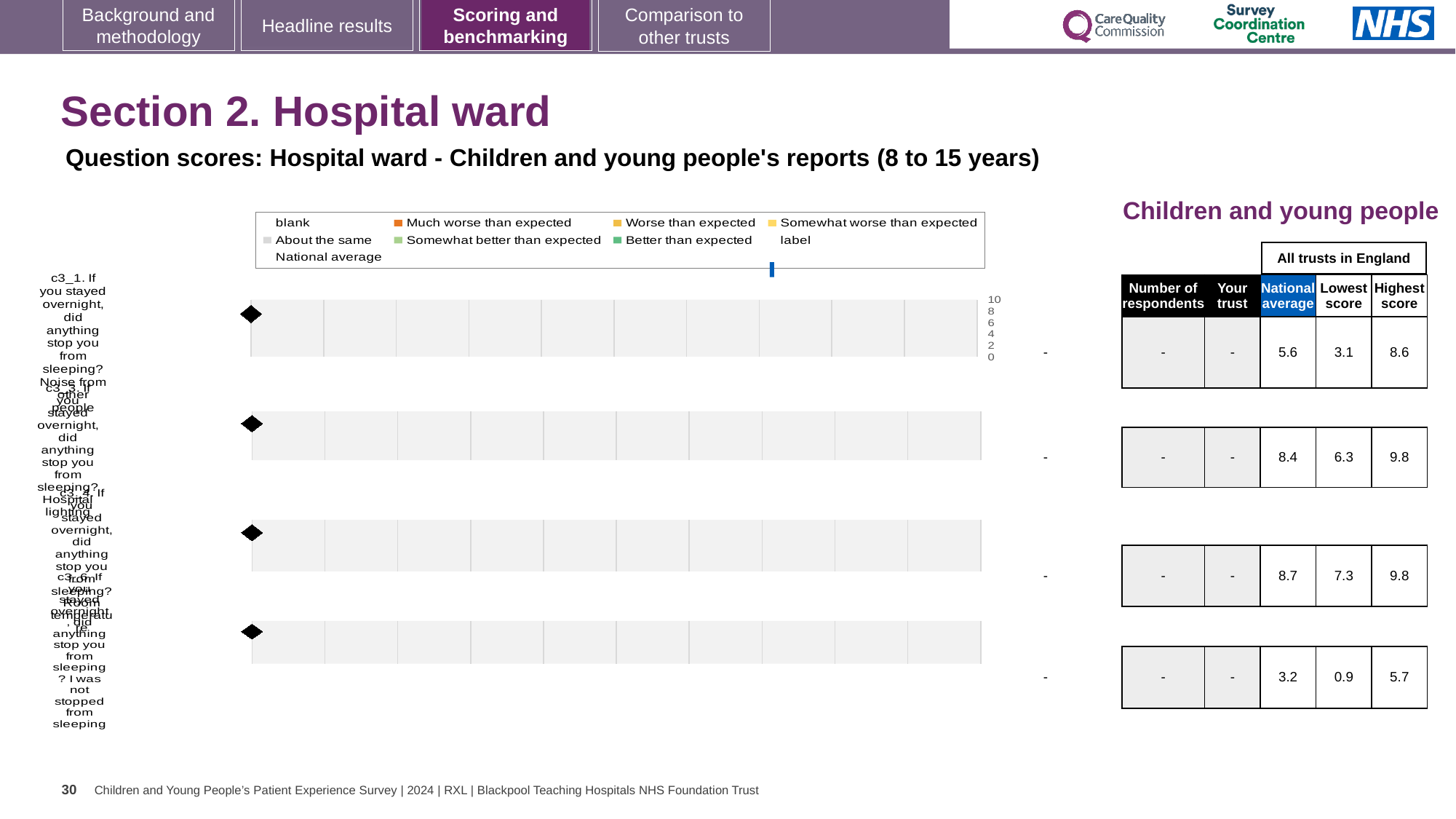
Which row has the highest national average in the table? c3_4 (room temperature) Is the national average for the second row (c3_3) larger or smaller than the national average for the first row (c3_1)? larger In the table, what is the highest score for the second row (c3_3, hospital lighting)? 9.8 In the table, what is the lowest score for the third row (c3_4, room temperature)? 7.3 How many question rows (categories) does the chart have? 4 In the table, what is the national average for the fourth row (c3_6, I was not stopped from sleeping)? 3.2 What is the difference between the highest score and the lowest score for the first row (c3_1) in the table? 5.5 Which legend entry is shown with an orange marker? Much worse than expected What kind of chart is shown on the slide? bar chart How many entries does the chart legend list? 9 In the table, what is the national average for the first row (c3_1, noise from other people)? 5.6 Which row has the lowest national average in the table? c3_6 (I was not stopped from sleeping)